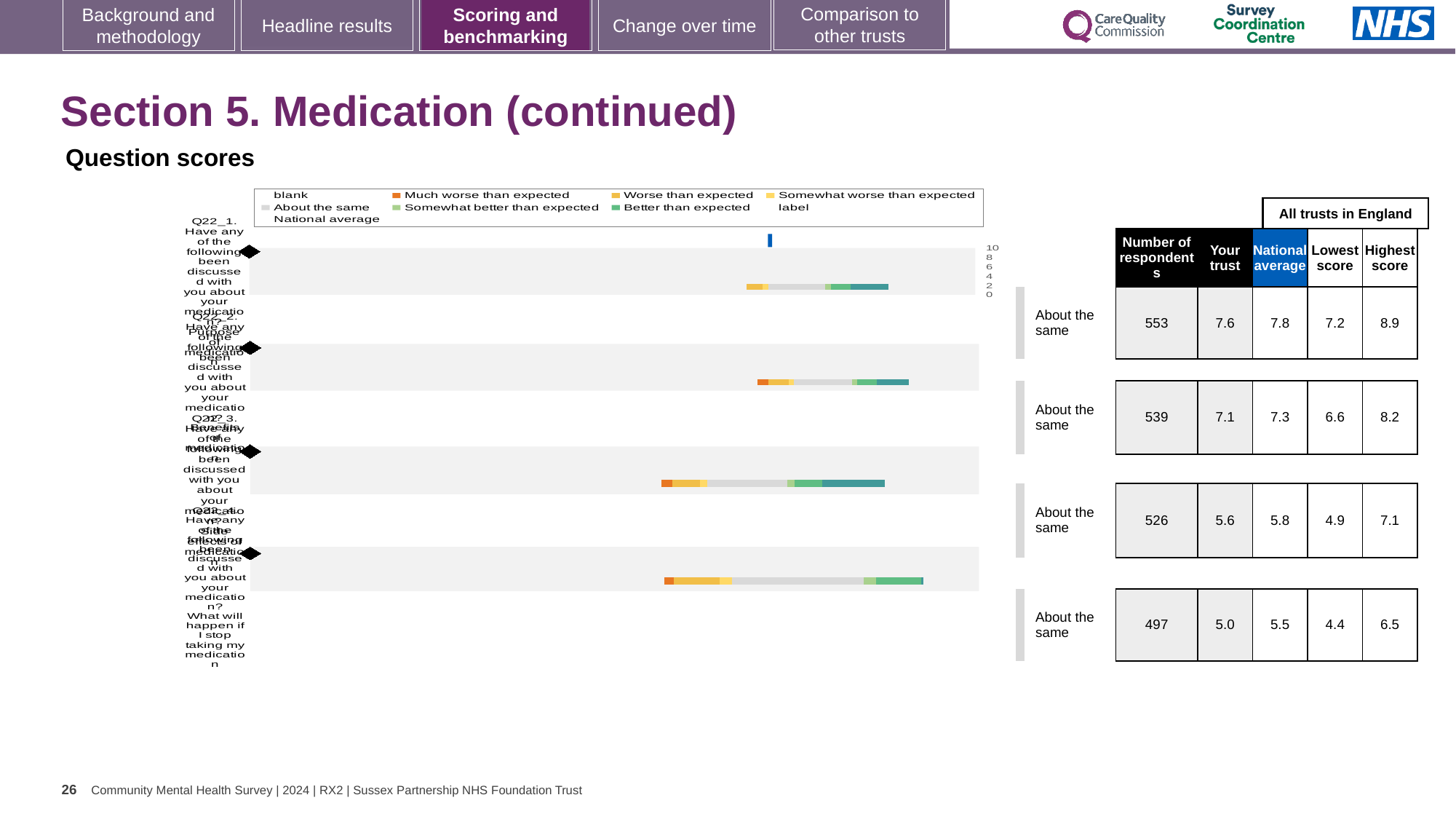
How many question rows (bars) are plotted in the chart? 4 How many respondents are listed for the third question row (Q22_3)? 526 What is the 'Your trust' score for the first question row (Q22_1)? 7.6 What is the difference between the national average and the 'Your trust' score for the fourth question row (Q22_4)? 0.5 What benchmark category is shown for every question row in the chart? About the same What is the national average for the second question row (Q22_2)? 7.3 Which legend entry is shown with an orange colour? Much worse than expected Which question row has the highest 'Your trust' score? Q22_1 (first row) Which question row has the lowest number of respondents? Q22_4 (fourth row) What is the highest score across all trusts in England for the fourth question row (Q22_4)? 6.5 Is the 'Your trust' score for the third question row (Q22_3) larger or smaller than its national average? smaller What kind of chart is shown under 'Question scores'? bar chart